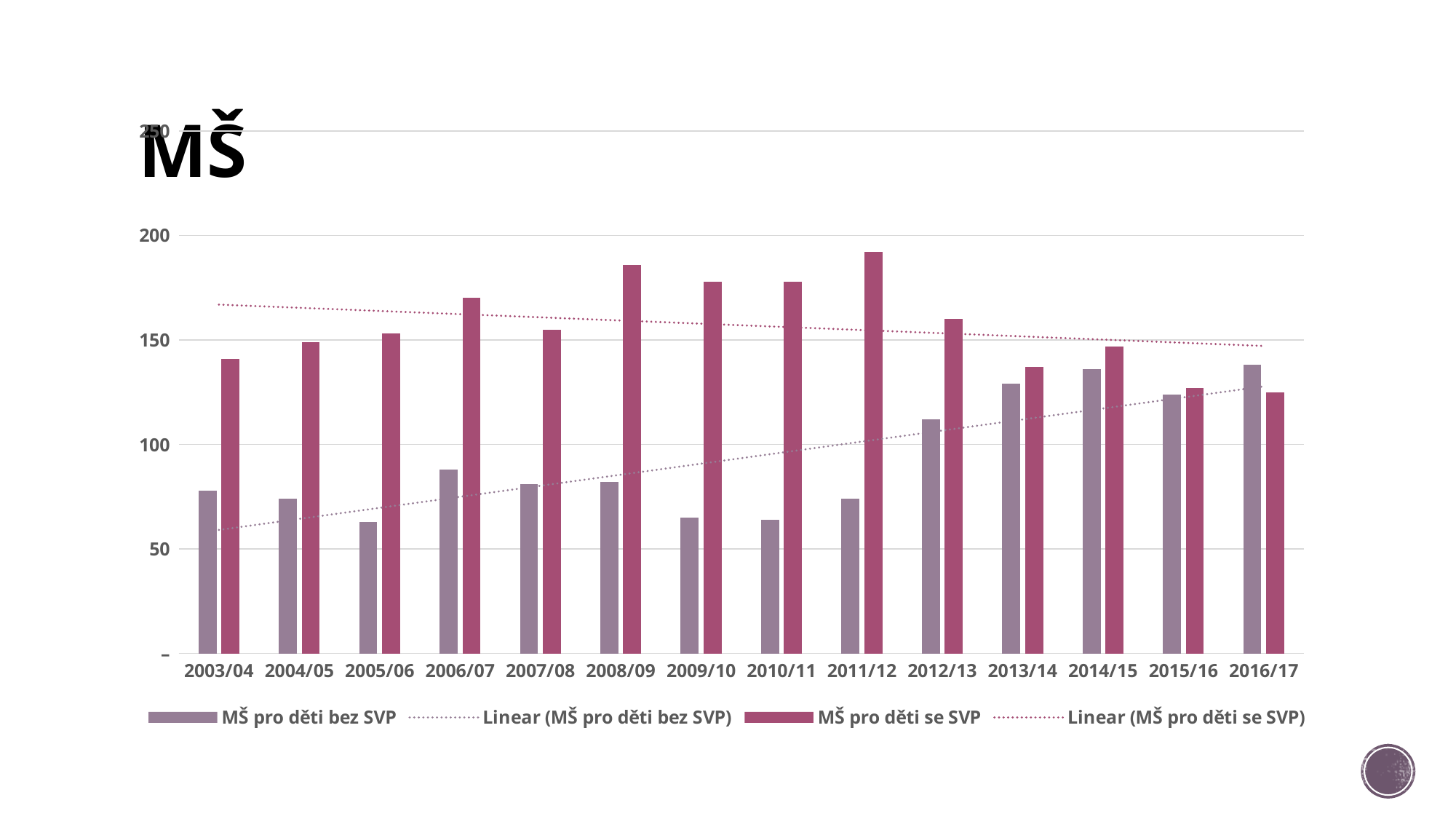
What is the title of the chart? MŠ Is the value for MŠ pro děti se SVP in 2016/17 greater or less than 150? less How many entries does the legend list? 4 Does the linear trendline for MŠ pro děti se SVP rise or fall from 2003/04 to 2016/17? fall How many school years are shown on the x axis? 14 Is the value for MŠ pro děti bez SVP in 2003/04 greater or less than 100? less In 2016/17, which is larger: MŠ pro děti bez SVP or MŠ pro děti se SVP? MŠ pro děti bez SVP In 2003/04, which is larger: MŠ pro děti bez SVP or MŠ pro děti se SVP? MŠ pro děti se SVP Is the value for MŠ pro děti se SVP in 2011/12 greater or less than 150? greater What kind of chart is shown on the slide? bar chart In which school year is the value for MŠ pro děti se SVP highest? 2011/12